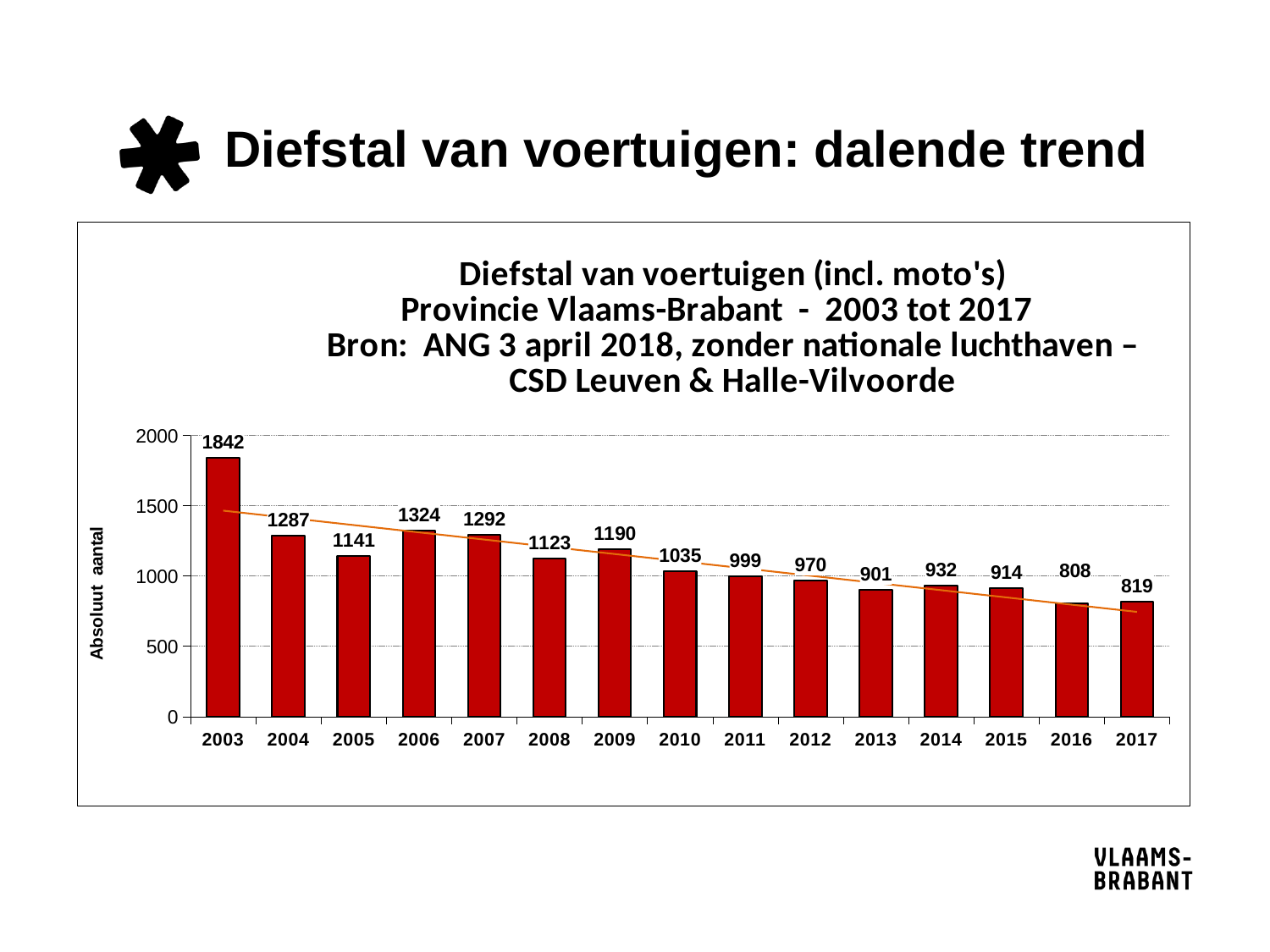
What is the value for 2003? 1842 Which is larger, the value for 2006 or the value for 2007? 2006 What kind of chart is this? bar chart What is the difference between the values for 2003 and 2004? 555 Do the values generally rise or fall from 2003 to 2017? fall Which year has the highest value? 2003 What is the value for 2017? 819 What is the difference between the values for 2016 and 2017? 11 What is the value for 2010? 1035 How many years are shown on the x axis? 15 Is the value for 2009 greater or less than 1000? greater Which year has the lowest value? 2016